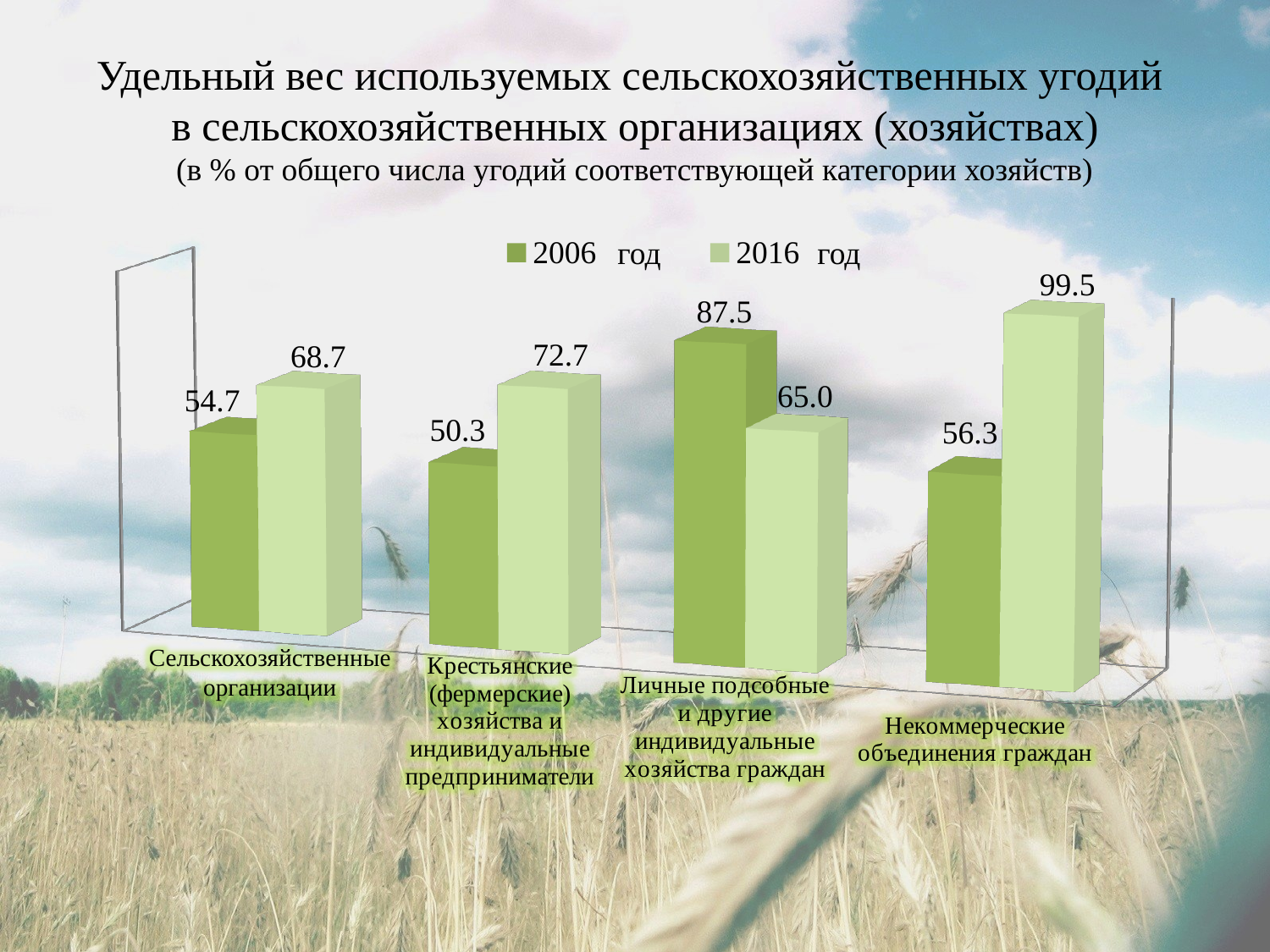
What is the 2016 год value for Крестьянские (фермерские) хозяйства и индивидуальные предприниматели? 72.7 Which is larger for Личные подсобные и другие индивидуальные хозяйства граждан: the 2006 год value or the 2016 год value? 2006 год What is the difference between the 2016 год and 2006 год values for Некоммерческие объединения граждан? 43.2 What kind of chart is shown on the slide? bar chart What is the difference between the 2016 год and 2006 год values for Сельскохозяйственные организации? 14.0 Which series is shown in the lighter green colour? 2016 год How many categories are shown on the x axis? 4 Which category has the highest 2006 год value? Личные подсобные и другие индивидуальные хозяйства граждан What is the 2016 год value for Некоммерческие объединения граждан? 99.5 How many series does the legend list? 2 What is the 2006 год value for Сельскохозяйственные организации? 54.7 Which category has the lowest 2016 год value? Личные подсобные и другие индивидуальные хозяйства граждан